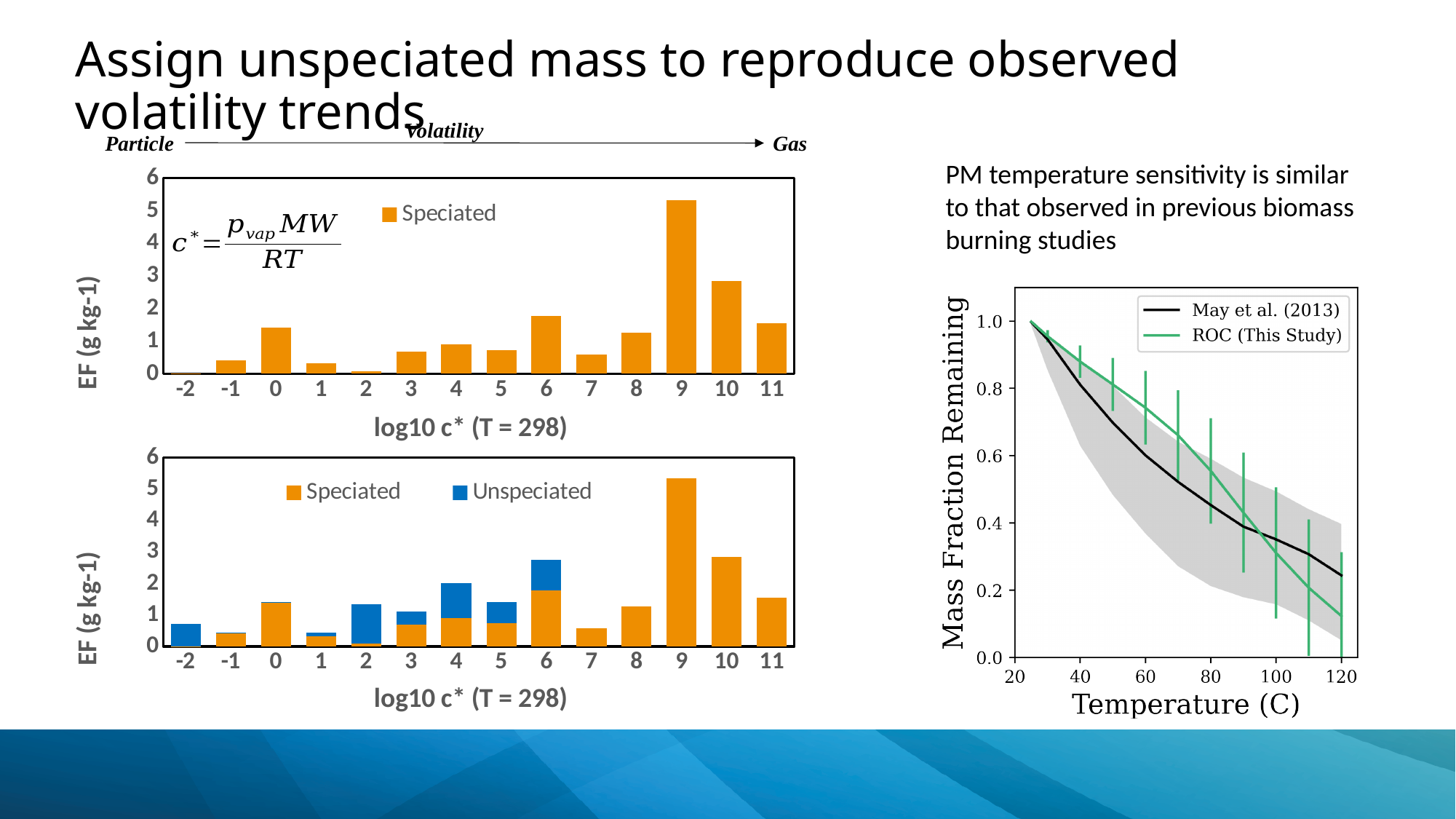
In the top-left bar chart, which log10 c* category has the highest EF? 9 In the right-hand line chart, is the May et al. (2013) value at 120 C greater or less than 0.4? less In the top-left bar chart, is the EF value for log10 c* = 0 greater or less than 2? less In the top-left bar chart, how many log10 c* categories are shown on the x axis? 14 In the right-hand line chart, does Mass Fraction Remaining rise or fall as Temperature increases? fall In the bottom-left bar chart, which has the larger total EF: log10 c* = 6 or log10 c* = 4? 6 In the top-left bar chart, is the EF value for log10 c* = 9 greater or less than 5? greater In the bottom-left bar chart, what colour represents the Unspeciated series? blue What kind of chart is the top-left chart? bar chart What kind of chart is the chart on the right (Mass Fraction Remaining vs Temperature)? line chart In the bottom-left bar chart, which log10 c* category has the highest total EF? 9 How many series does the legend of the bottom-left bar chart list? 2